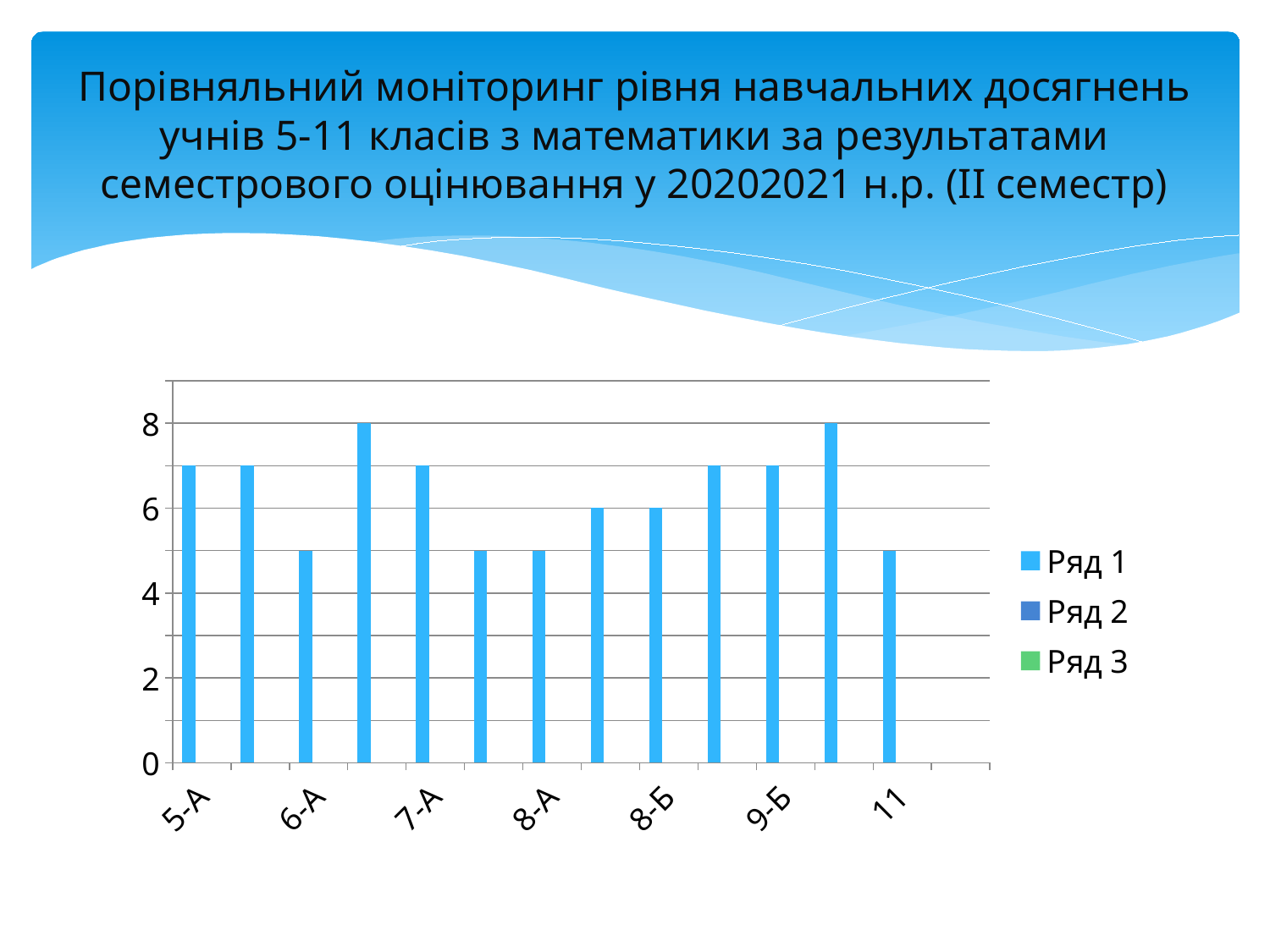
How many series does the legend list? 3 Which is larger, the value for 8-Б or the value for 8-A? 8-Б What kind of chart is shown on the slide? bar chart Which is larger, the value for 5-A or the value for 6-A? 5-A Is the value for 9-Б greater or less than 4? greater What is the name of the first series in the legend? Ряд 1 What is the value for 8-Б? 6 How many bars are plotted in the chart? 13